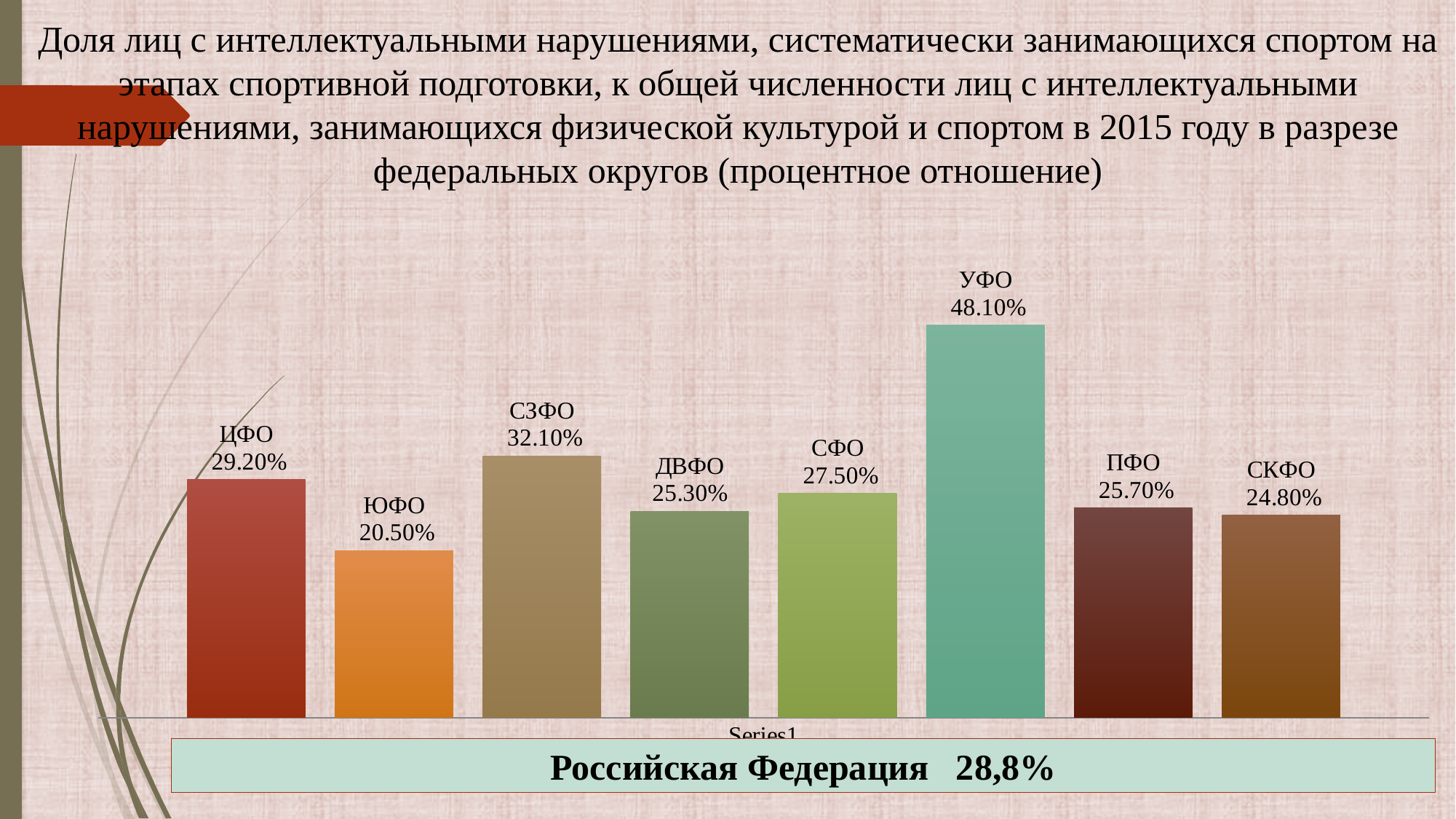
Which is larger, the value for СФО or the value for ДВФО? СФО What is the difference between the values for ЦФО and ПФО? 3.50% What is the value for СЗФО? 32.10% How many federal districts are shown in the chart? 8 Which federal district has the highest value? УФО What is the value for СКФО? 24.80% What is the value for ЮФО? 20.50% What is the difference between the values for УФО and ЮФО? 27.60% What kind of chart is shown on the slide? Bar chart What is the value for УФО? 48.10% Which federal district has the lowest value? ЮФО What value is given for the Российская Федерация in the box below the chart? 28,8%